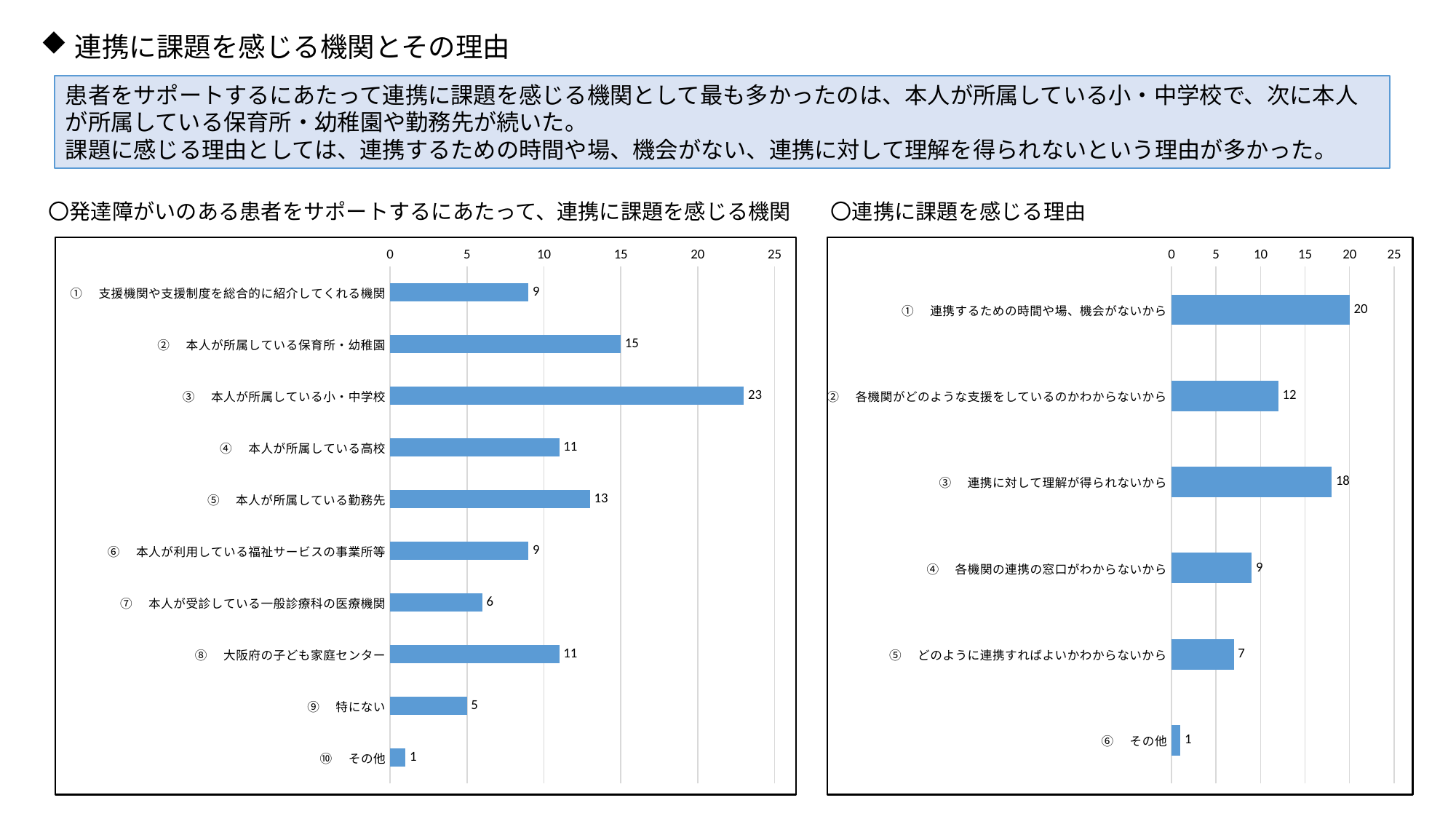
In the left chart (連携に課題を感じる機関), what is the value for ⑦ 本人が受診している一般診療科の医療機関? 6 In the left chart (連携に課題を感じる機関), which category has the lowest value? ⑩ その他 In the left chart (連携に課題を感じる機関), how many categories are shown? 10 In the left chart (連携に課題を感じる機関), which category has the highest value? ③ 本人が所属している小・中学校 In the right chart (連携に課題を感じる理由), how many categories are shown? 6 In the left chart (連携に課題を感じる機関), what is the difference between ② 本人が所属している保育所・幼稚園 and ⑤ 本人が所属している勤務先? 2 In the right chart (連携に課題を感じる理由), what is the difference between ① 連携するための時間や場、機会がないから and ② 各機関がどのような支援をしているのかわからないから? 8 What kind of chart is the right chart (連携に課題を感じる理由)? Bar chart In the left chart (連携に課題を感じる機関), which is larger: ④ 本人が所属している高校 or ⑨ 特にない? ④ 本人が所属している高校 In the right chart (連携に課題を感じる理由), what is the value for ③ 連携に対して理解が得られないから? 18 In the right chart (連携に課題を感じる理由), which category has the highest value? ① 連携するための時間や場、機会がないから In the left chart (連携に課題を感じる機関), what is the value for ③ 本人が所属している小・中学校? 23